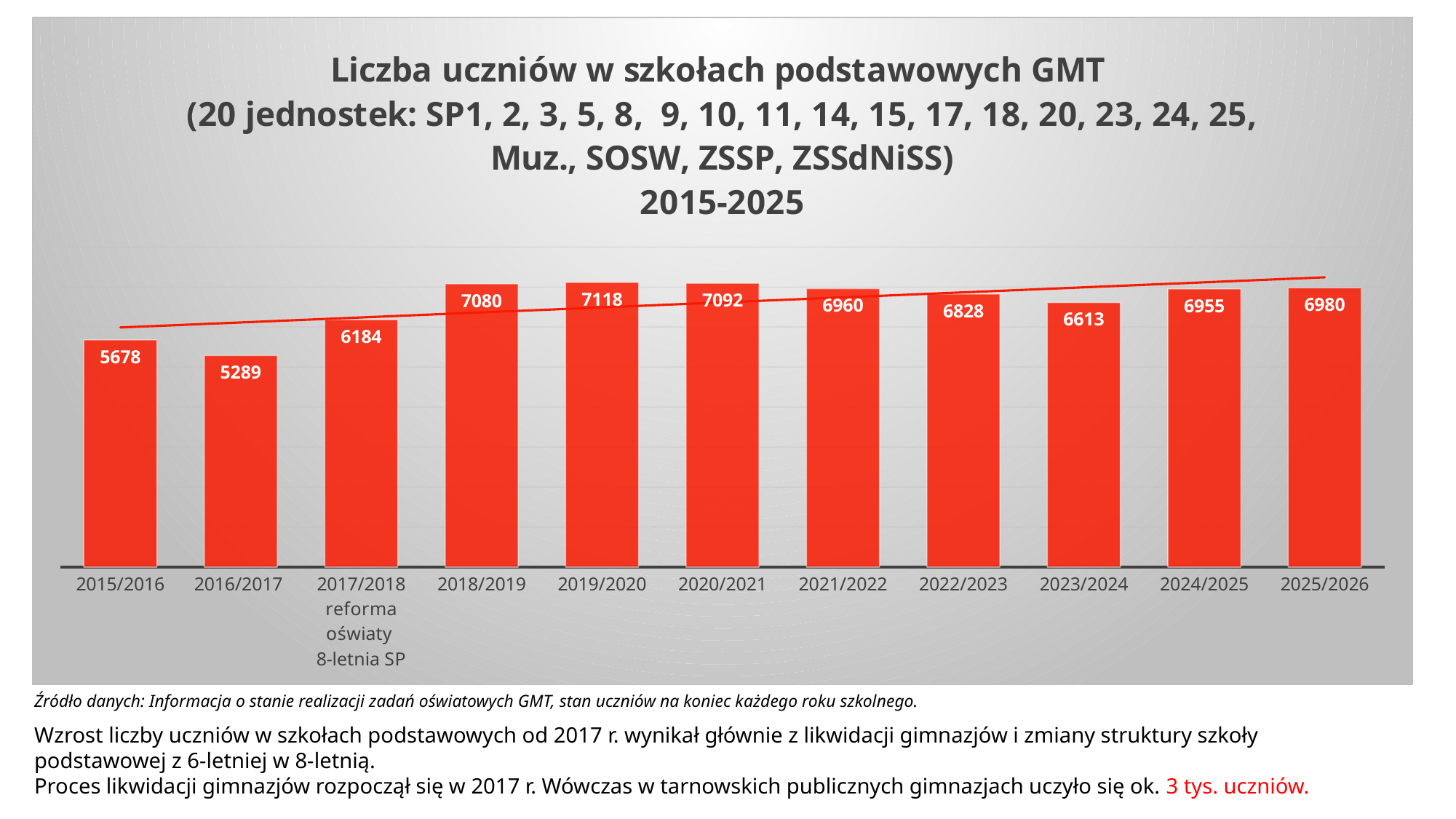
By how much does the value for 2025/2026 exceed the value for 2015/2016? 1302 What is the number of pupils shown for 2015/2016? 5678 Which is larger, the value for 2021/2022 or the value for 2024/2025? 2021/2022 What is the value for 2023/2024? 6613 Which school year has the lowest number of pupils? 2016/2017 Which school year has the highest number of pupils? 2019/2020 How many school years (bars) are shown on the chart? 11 What value is labelled on the bar for 2025/2026? 6980 What type of chart is shown on the slide? Bar chart What is the difference between the values for 2018/2019 and 2017/2018? 896 What value is shown for the 2019/2020 school year? 7118 Which school year is annotated with 'reforma oświaty 8-letnia SP' on the x axis? 2017/2018